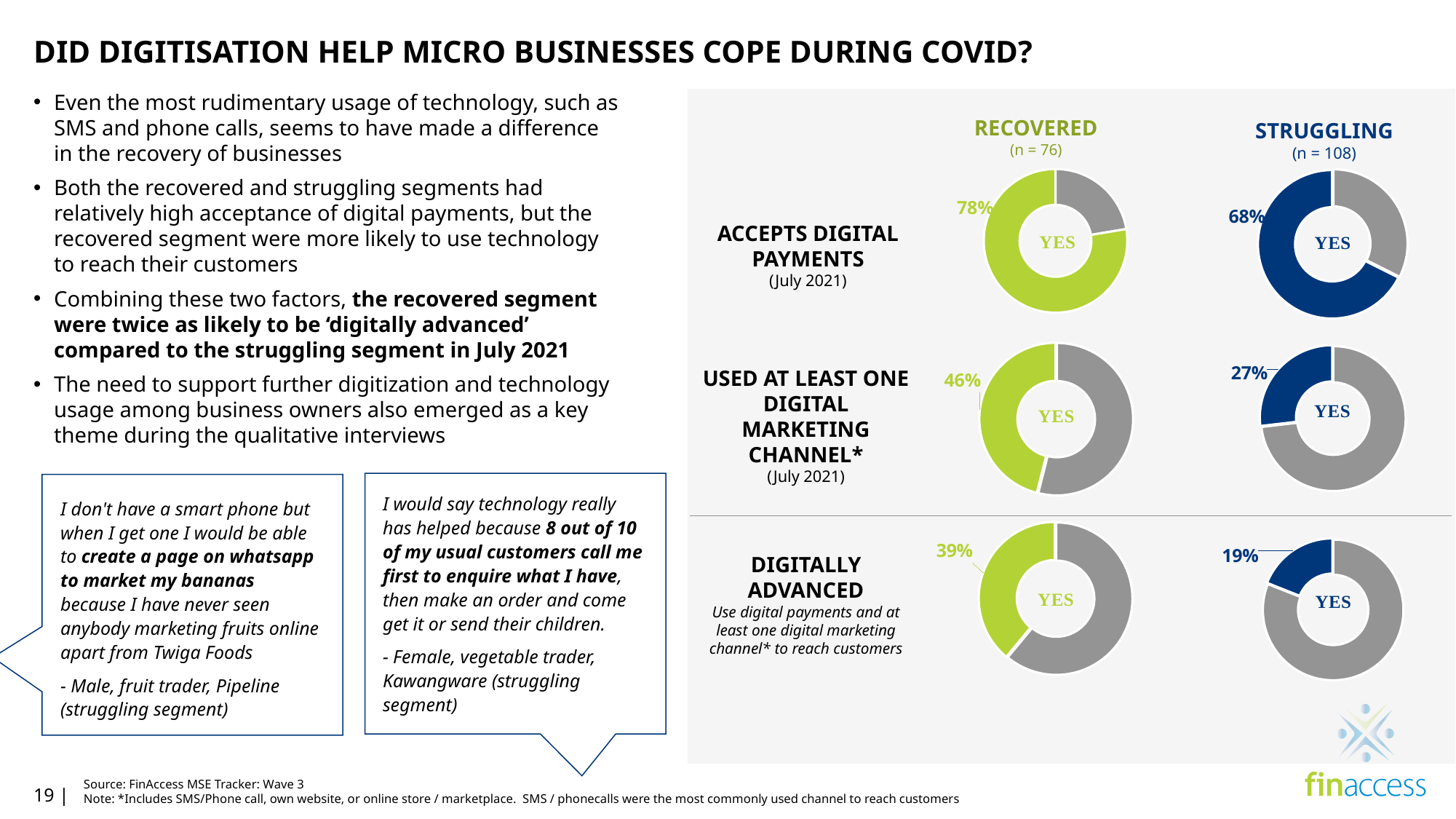
In the 'Digitally advanced' row, what percentage of the Struggling segment answered yes? 19% What type of chart is used to show the yes percentages on the right side of the slide? Donut (pie) chart Across all six donut charts, which chart shows the lowest yes percentage? Struggling, Digitally advanced (19%) In the 'Accepts digital payments' row, what percentage of the Struggling segment answered yes? 68% In the 'Accepts digital payments' row, which segment has the higher yes percentage, Recovered or Struggling? Recovered How many donut charts are shown on the slide? 6 In the 'Accepts digital payments' row, what percentage of the Recovered segment answered yes? 78% Across all six donut charts, which chart shows the highest yes percentage? Recovered, Accepts digital payments (78%) In the 'Used at least one digital marketing channel' row, what percentage of the Struggling segment answered yes? 27% In the 'Digitally advanced' row, what is the difference between the Recovered and Struggling yes percentages? 20 percentage points What is the sample size (n) for the Struggling segment? n = 108 In the 'Used at least one digital marketing channel' row, what percentage of the Recovered segment answered yes? 46%